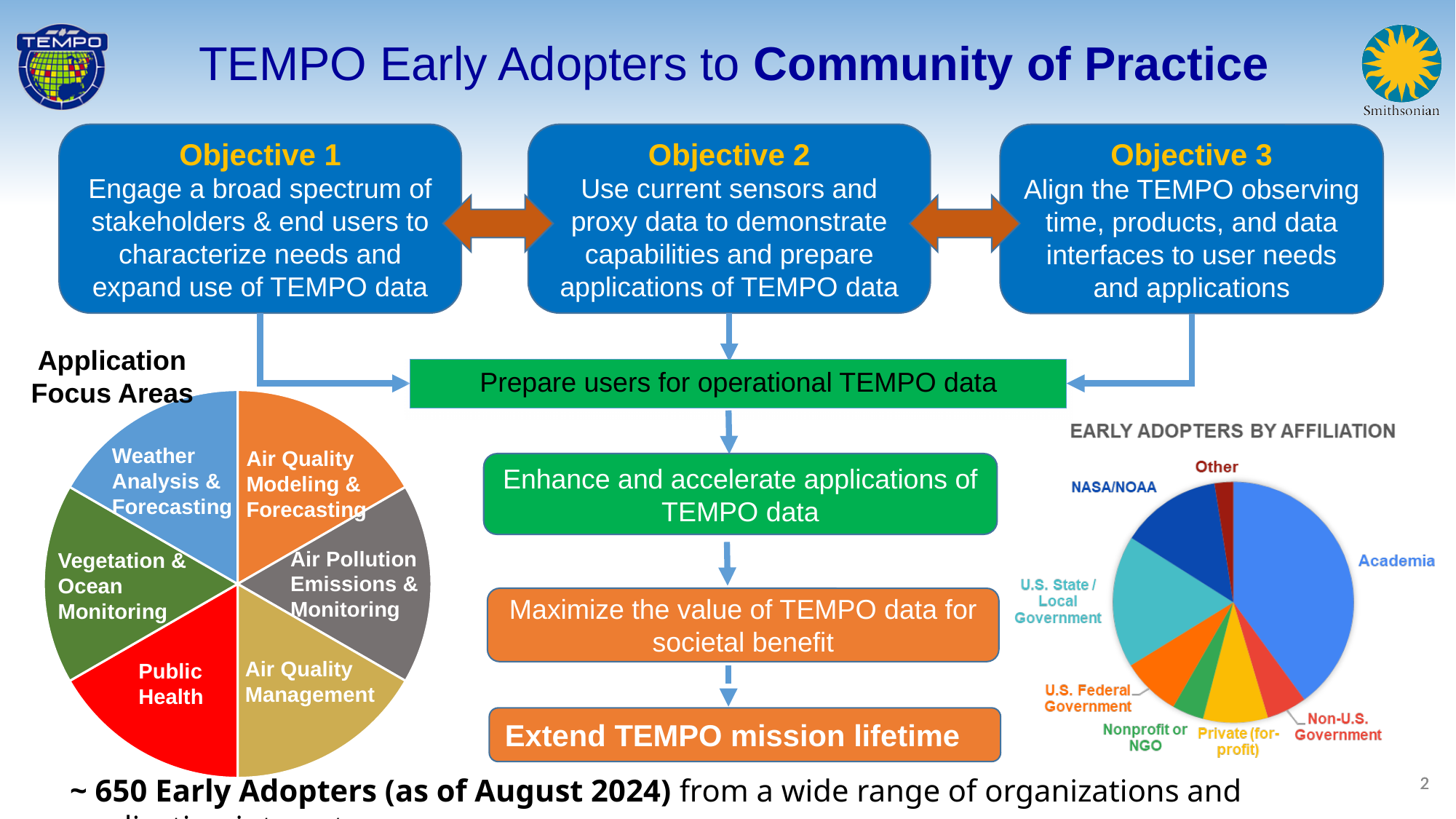
In the 'Application Focus Areas' pie chart, what colour is the Public Health slice? Red In the 'EARLY ADOPTERS BY AFFILIATION' chart, which is larger: NASA/NOAA or Other? NASA/NOAA What kind of chart is the 'EARLY ADOPTERS BY AFFILIATION' chart on the right of the slide? Pie chart In the 'EARLY ADOPTERS BY AFFILIATION' chart, which is larger: Academia or U.S. State / Local Government? Academia How many slices does the 'Application Focus Areas' pie chart have? 6 In the 'EARLY ADOPTERS BY AFFILIATION' chart, which affiliation has the largest slice? Academia In the 'EARLY ADOPTERS BY AFFILIATION' chart, which is larger: U.S. State / Local Government or Nonprofit or NGO? U.S. State / Local Government In the 'EARLY ADOPTERS BY AFFILIATION' chart, which affiliation has the smallest slice? Other How many affiliation categories does the 'EARLY ADOPTERS BY AFFILIATION' pie chart show? 8 What kind of chart is the 'Application Focus Areas' chart on the left of the slide? Pie chart What is the title of the pie chart on the right of the slide? EARLY ADOPTERS BY AFFILIATION